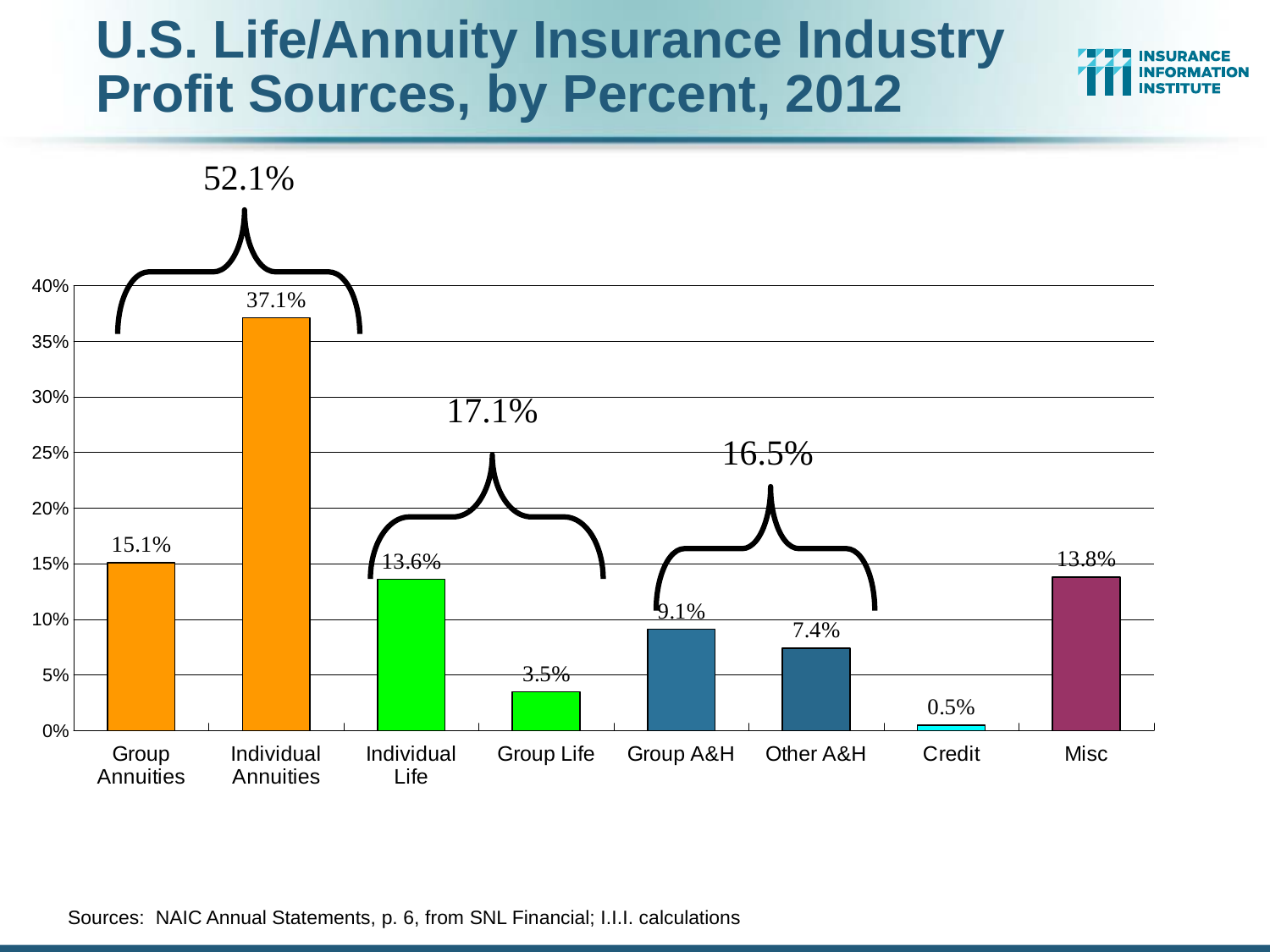
What combined percentage is shown by the bracket over Group Annuities and Individual Annuities? 52.1% What kind of chart is this? bar chart What is the difference between the values for Group A&H and Other A&H? 1.7% What is the value for Group Life? 3.5% What combined percentage is shown by the bracket over Group A&H and Other A&H? 16.5% How many categories are shown on the x axis? 8 Which category has the lowest value? Credit Which is larger, the value for Group Annuities or the value for Individual Life? Group Annuities What is the value for Individual Annuities? 37.1% Which category has the highest value? Individual Annuities What is the value for Misc? 13.8% Is the value for Individual Annuities greater or less than 35%? greater